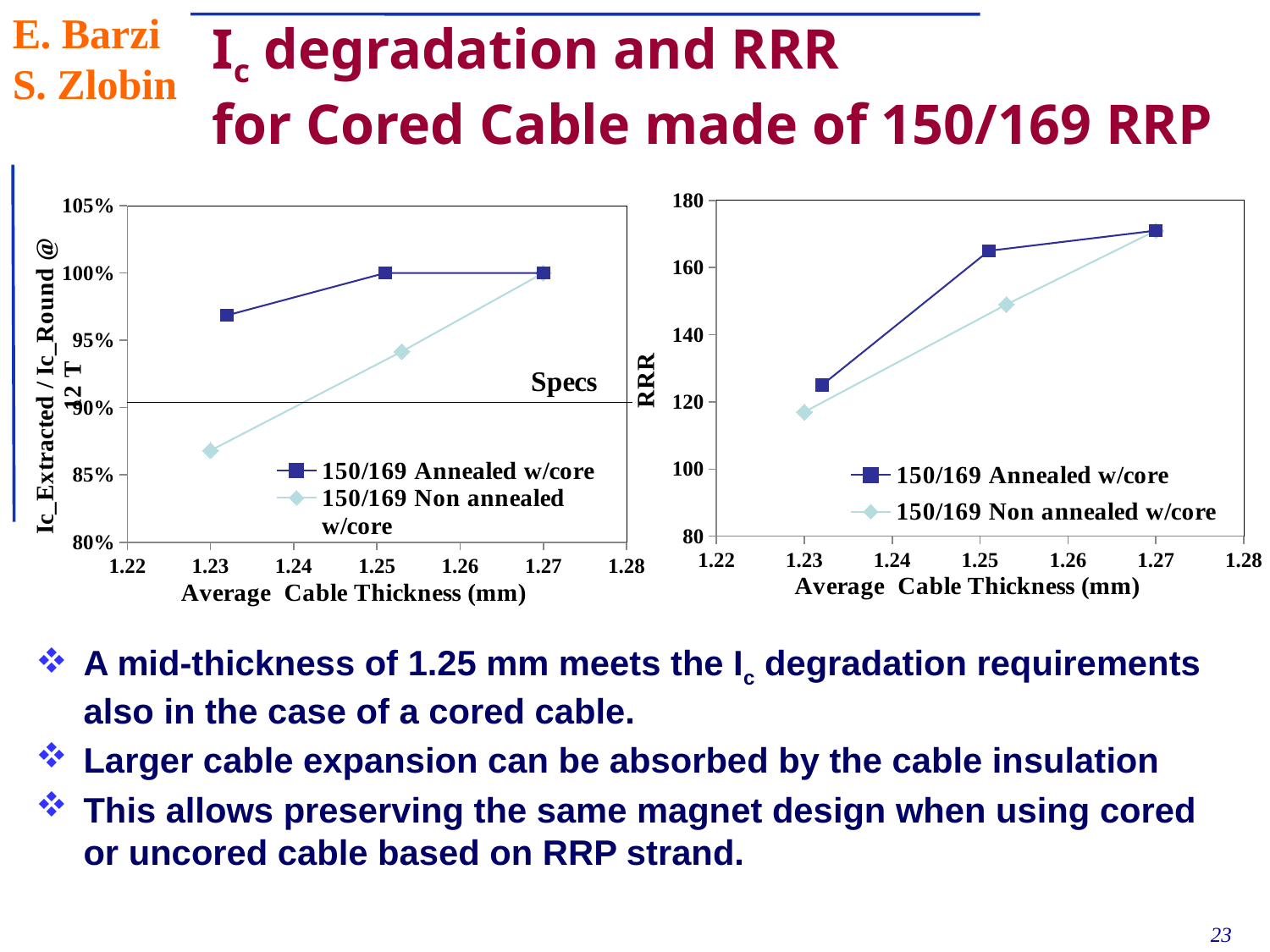
What is the x-axis label of the left chart? Average Cable Thickness (mm) In the left chart (Ic_Extracted / Ic_Round @ 12 T), is the value for 150/169 Non annealed w/core at about 1.23 mm greater or less than 90%? less What type of chart is the left chart (Ic_Extracted / Ic_Round @ 12 T)? line chart In the left chart (Ic_Extracted / Ic_Round @ 12 T), is the value for 150/169 Annealed w/core at about 1.23 mm greater or less than 95%? greater In the right chart (RRR), at about 1.25 mm, which series has the higher RRR: 150/169 Annealed w/core or 150/169 Non annealed w/core? 150/169 Annealed w/core In the right chart (RRR), is the RRR for 150/169 Annealed w/core at about 1.25 mm greater or less than 160? greater What type of chart is the right chart (RRR)? line chart In the left chart (Ic_Extracted / Ic_Round @ 12 T), how many data points are plotted for the 150/169 Non annealed w/core series? 3 How many series does the legend of the right chart (RRR) list? 2 In the right chart (RRR), does RRR rise or fall as Average Cable Thickness increases for the 150/169 Non annealed w/core series? rise In the right chart (RRR), how many data points are plotted for the 150/169 Annealed w/core series? 3